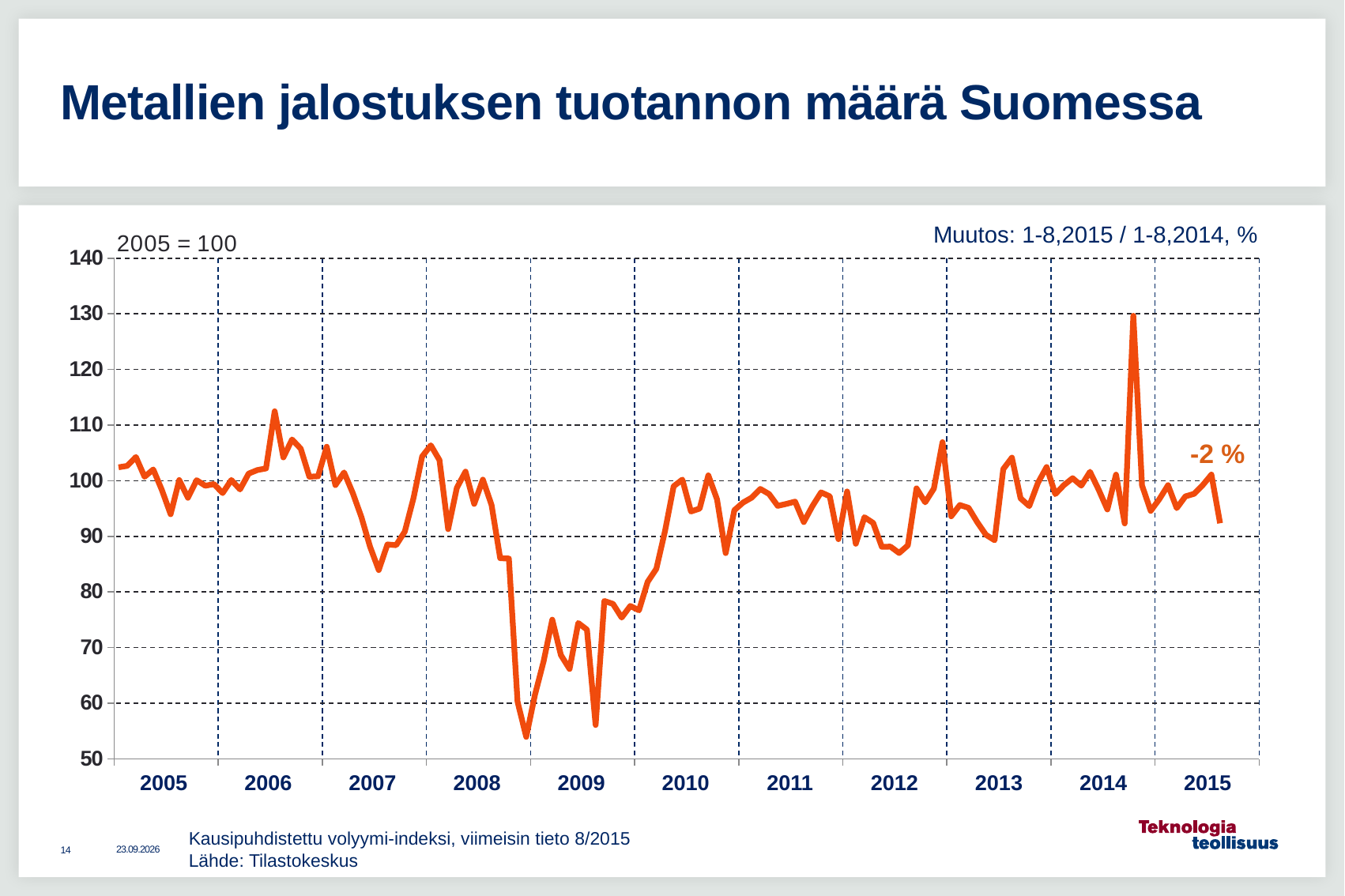
What percentage change is annotated next to the end of the line? -2 % What is the title of the slide's chart? Metallien jalostuksen tuotannon määrä Suomessa In which year does the line reach its highest point? 2014 Is the peak value of the line in 2014 greater or less than 120? greater In which year does the line reach its lowest point? 2008 Is the lowest value of the line in 2008 greater or less than 60? less Does the line rise or fall from the middle of 2008 to the end of 2008? fall What base-year note is printed above the y axis? 2005 = 100 How many year labels are shown on the x axis? 11 Does the line rise or fall from the middle of 2009 to the start of 2010? rise Is the value at the start of 2005 greater or less than 90? greater What kind of chart is shown on the slide? line chart